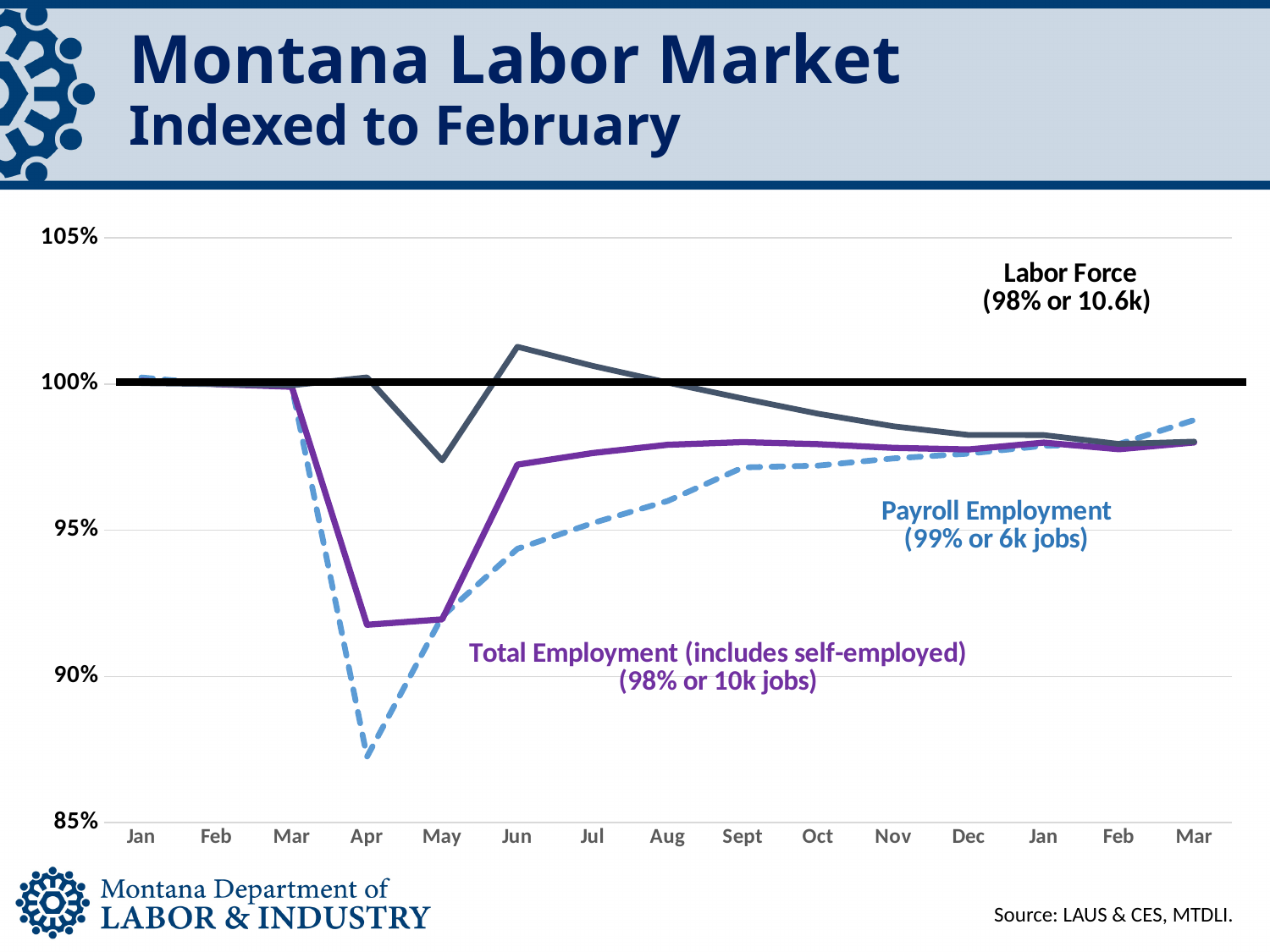
How many data series are plotted on the chart? 3 In which month does Labor Force reach its highest value? Jun In Apr, which series has the higher value: Labor Force or Payroll Employment? Labor Force In which month does Payroll Employment reach its lowest value? Apr Is the value for Payroll Employment in Apr greater or less than 90%? less Is the value for Labor Force in May greater or less than 100%? less Is the value for Labor Force in Jun greater or less than 100%? greater According to the annotation on the chart, what level is Payroll Employment at relative to February? 99% or 6k jobs Does Payroll Employment rise or fall from Apr to the final Mar? rise How many months are shown along the x axis of the chart? 15 What kind of chart is shown on the slide? line chart